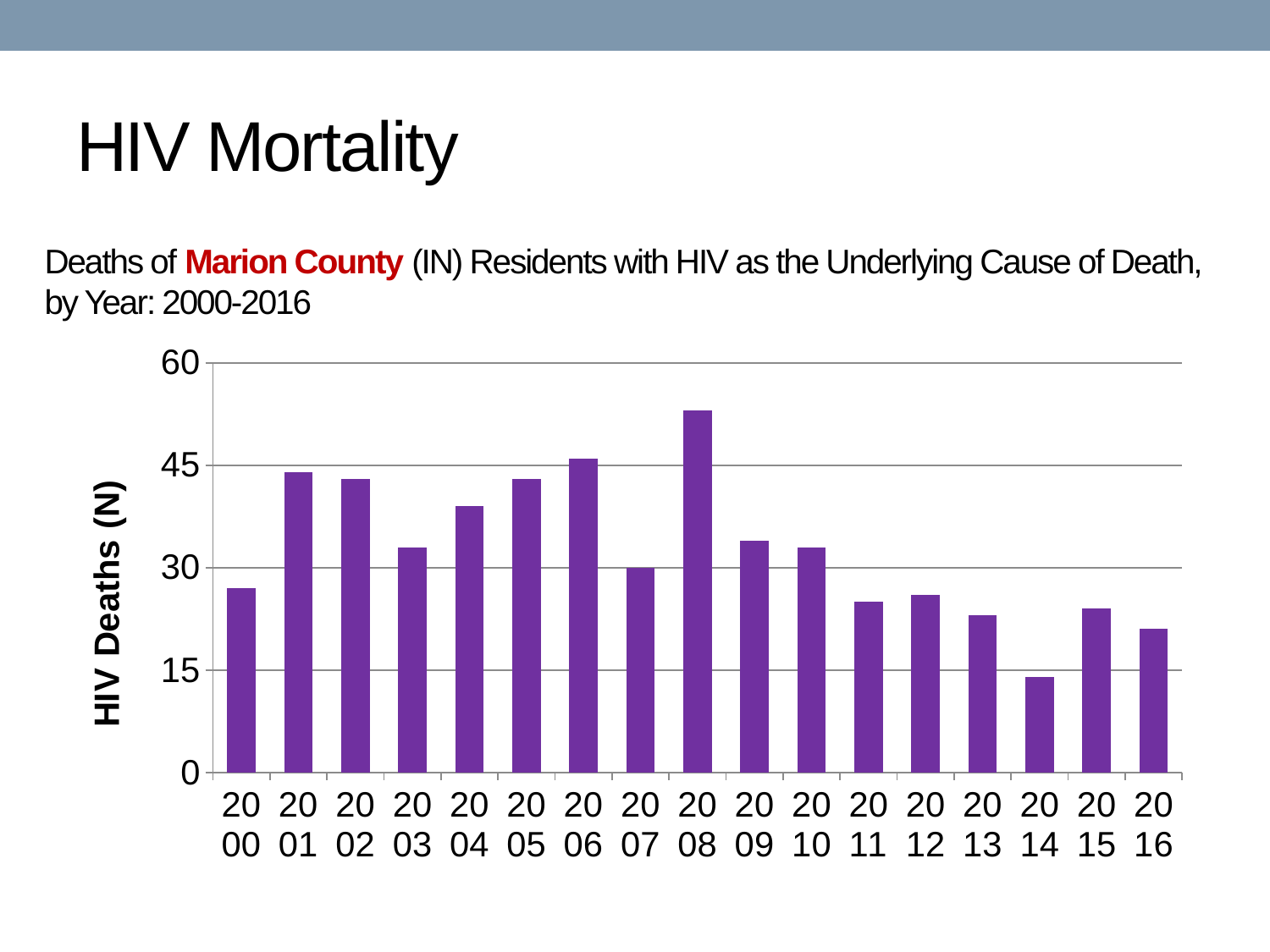
What kind of chart is shown on the slide? bar chart How many years (bars) are plotted in the chart? 17 Which year has more HIV deaths, 2001 or 2013? 2001 Is the value for 2008 greater or less than 45? greater Is the value for 2000 greater or less than 30? less Which year has the lowest number of HIV deaths? 2014 Which year has the highest number of HIV deaths? 2008 What is the label on the vertical axis of the chart? HIV Deaths (N) Which year has more HIV deaths, 2008 or 2000? 2008 Is the value for 2011 greater or less than 30? less